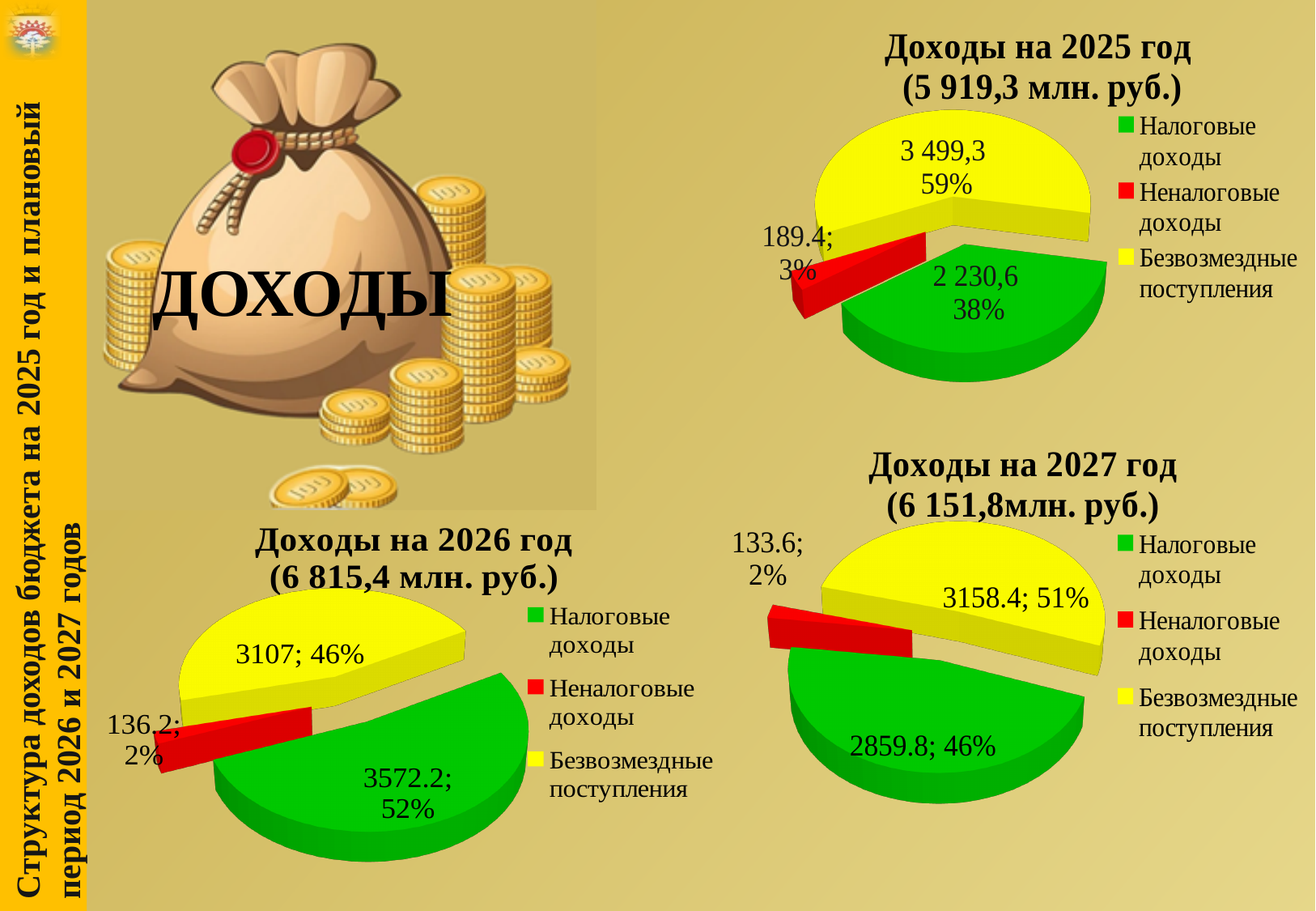
In the chart 'Доходы на 2025 год', what is the value for Безвозмездные поступления? 3 499,3 What kind of chart is 'Доходы на 2025 год'? Pie chart In the chart 'Доходы на 2027 год', what share of the pie is Налоговые доходы? 46% In the chart 'Доходы на 2027 год', what colour represents Неналоговые доходы? Red In the chart 'Доходы на 2025 год', which category is the smallest? Неналоговые доходы In the chart 'Доходы на 2025 год', what share of the pie is Налоговые доходы? 38% In the chart 'Доходы на 2026 год', which category is the largest? Налоговые доходы How many categories does the chart 'Доходы на 2026 год' show? 3 In the chart 'Доходы на 2026 год', what share of the pie is Безвозмездные поступления? 46% In the chart 'Доходы на 2026 год', what is the value for Налоговые доходы? 3572.2 In the chart 'Доходы на 2027 год', what is the value for Неналоговые доходы? 133.6 In the chart 'Доходы на 2027 год', which is larger, Налоговые доходы or Безвозмездные поступления? Безвозмездные поступления